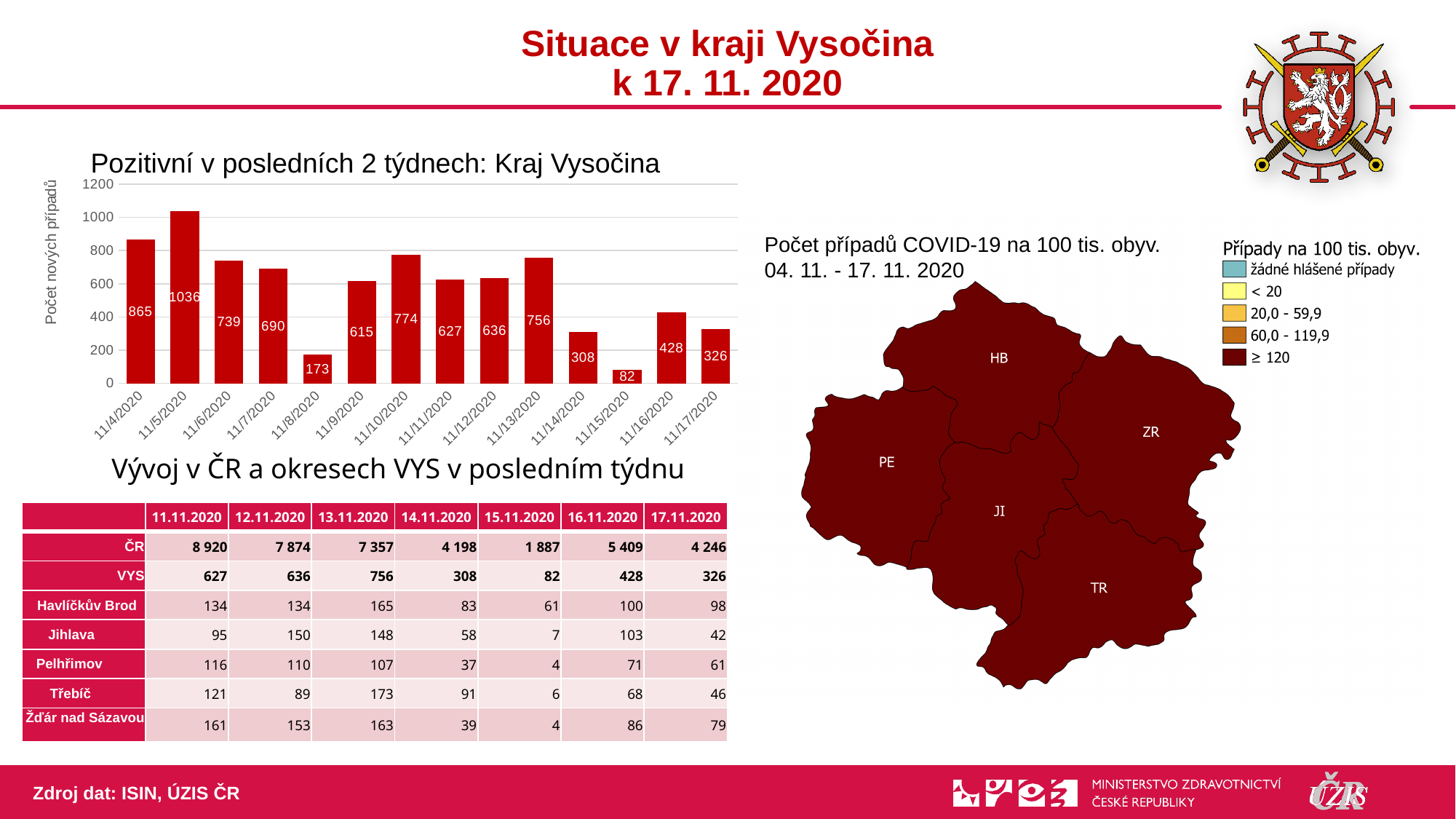
How many dates are shown on the x axis of the bar chart? 14 What type of chart is 'Pozitivní v posledních 2 týdnech: Kraj Vysočina'? bar chart In the bar chart, what is the value for 11/5/2020? 1036 What is the label of the y axis of the bar chart? Počet nových případů In the bar chart, what is the value for 11/15/2020? 82 In the bar chart, is the value for 11/16/2020 greater or less than 400? greater Which date has the lowest value in the bar chart? 11/15/2020 In the bar chart, which is larger: the value for 11/13/2020 or the value for 11/6/2020? 11/13/2020 In the bar chart, what is the difference between the values for 11/12/2020 and 11/11/2020? 9 In the bar chart, what is the value for 11/10/2020? 774 Which date has the highest value in the bar chart? 11/5/2020 In the bar chart, what is the difference between the values for 11/4/2020 and 11/8/2020? 692